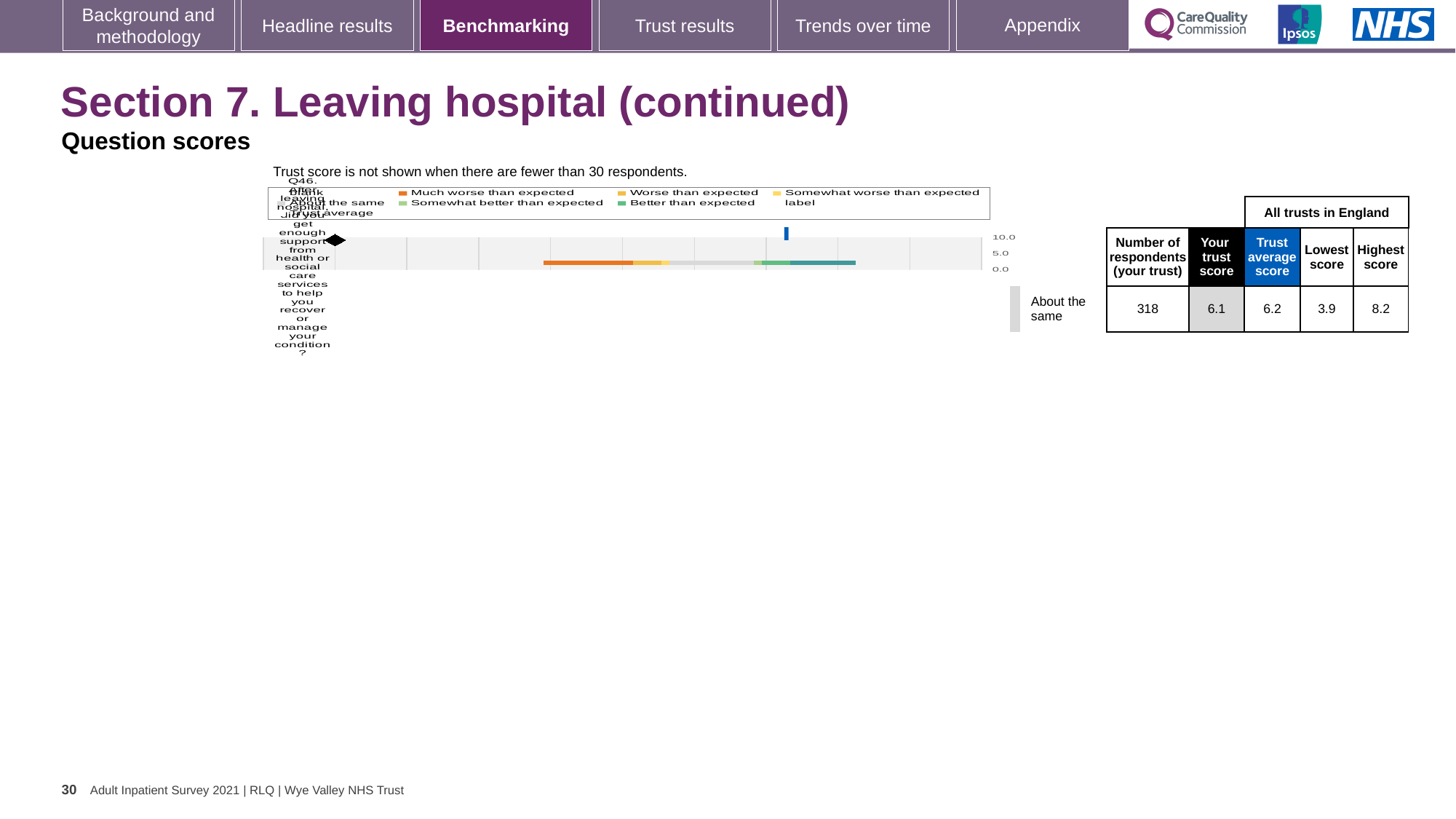
What is the trust average score for Q46? 6.2 What is the maximum value shown on the chart's score axis? 10.0 How many respondents from the trust answered Q46? 318 Which is larger for Q46, the trust score or the trust average score? Trust average score What is the highest score across all trusts in England for Q46? 8.2 What kind of chart is shown on the slide? bar chart How many survey questions are plotted in the chart? 1 What is the lowest score across all trusts in England for Q46? 3.9 Is the trust score for Q46 greater or less than 5.0 on the chart's axis? greater What is the difference between the highest score and the lowest score for Q46? 4.3 What is the trust score for Q46 shown in the table next to the chart? 6.1 What benchmark category is the trust's Q46 result placed in? About the same